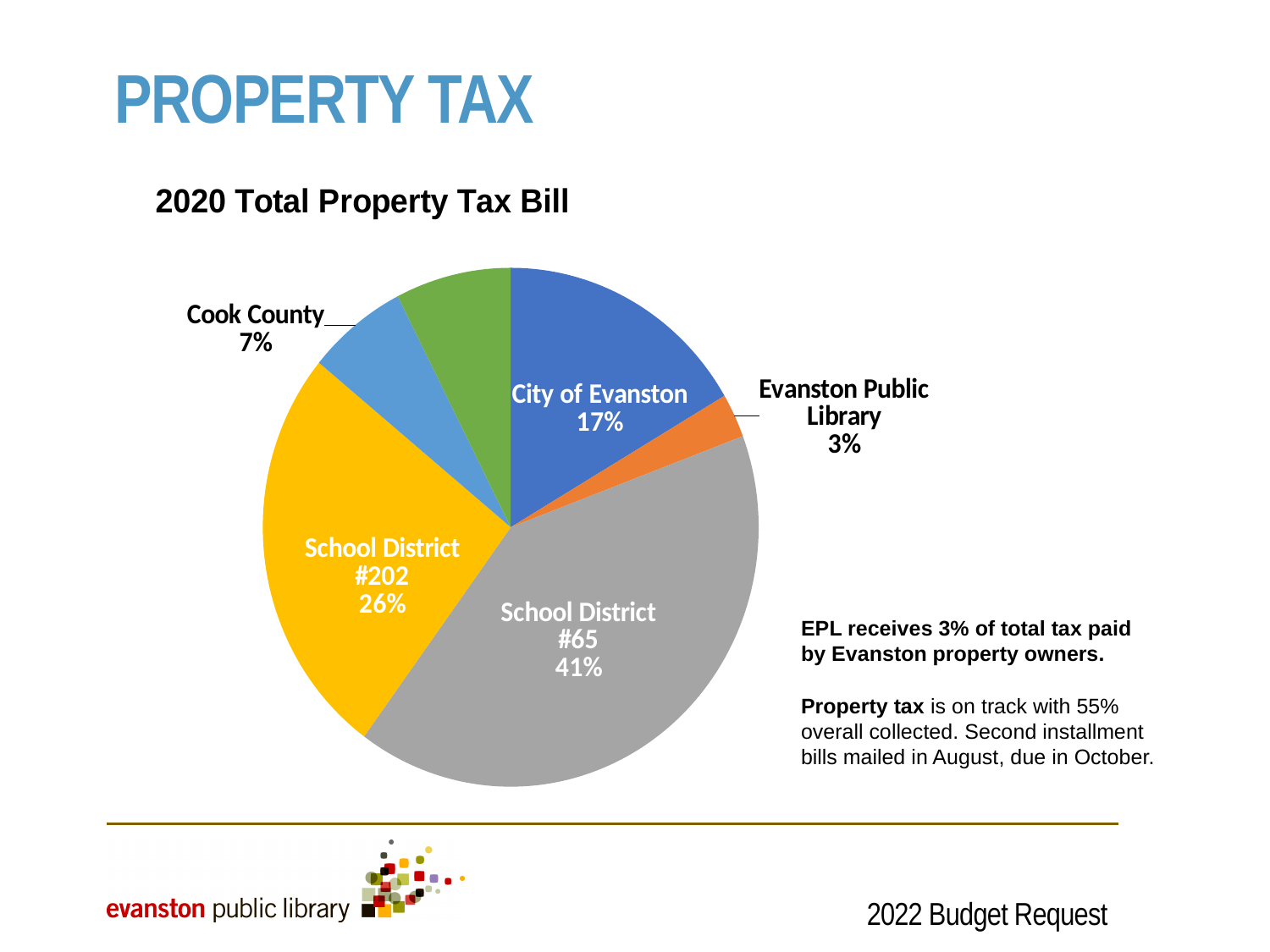
What share of the 2020 total property tax bill goes to School District #202? 26% What share of the 2020 total property tax bill goes to Cook County? 7% How many percentage points larger is the School District #65 share than the School District #202 share? 15 Which labeled slice has the smallest share of the 2020 total property tax bill? Evanston Public Library What type of chart is shown on the slide? pie chart Which receives a larger share of the property tax bill, the City of Evanston or Cook County? City of Evanston What share of the 2020 total property tax bill goes to the City of Evanston? 17% Which labeled slice has the largest share of the 2020 total property tax bill? School District #65 What share of the 2020 total property tax bill goes to School District #65? 41% What is the title of the chart? 2020 Total Property Tax Bill What colour is the School District #202 slice? yellow What share of the 2020 total property tax bill goes to the Evanston Public Library? 3%